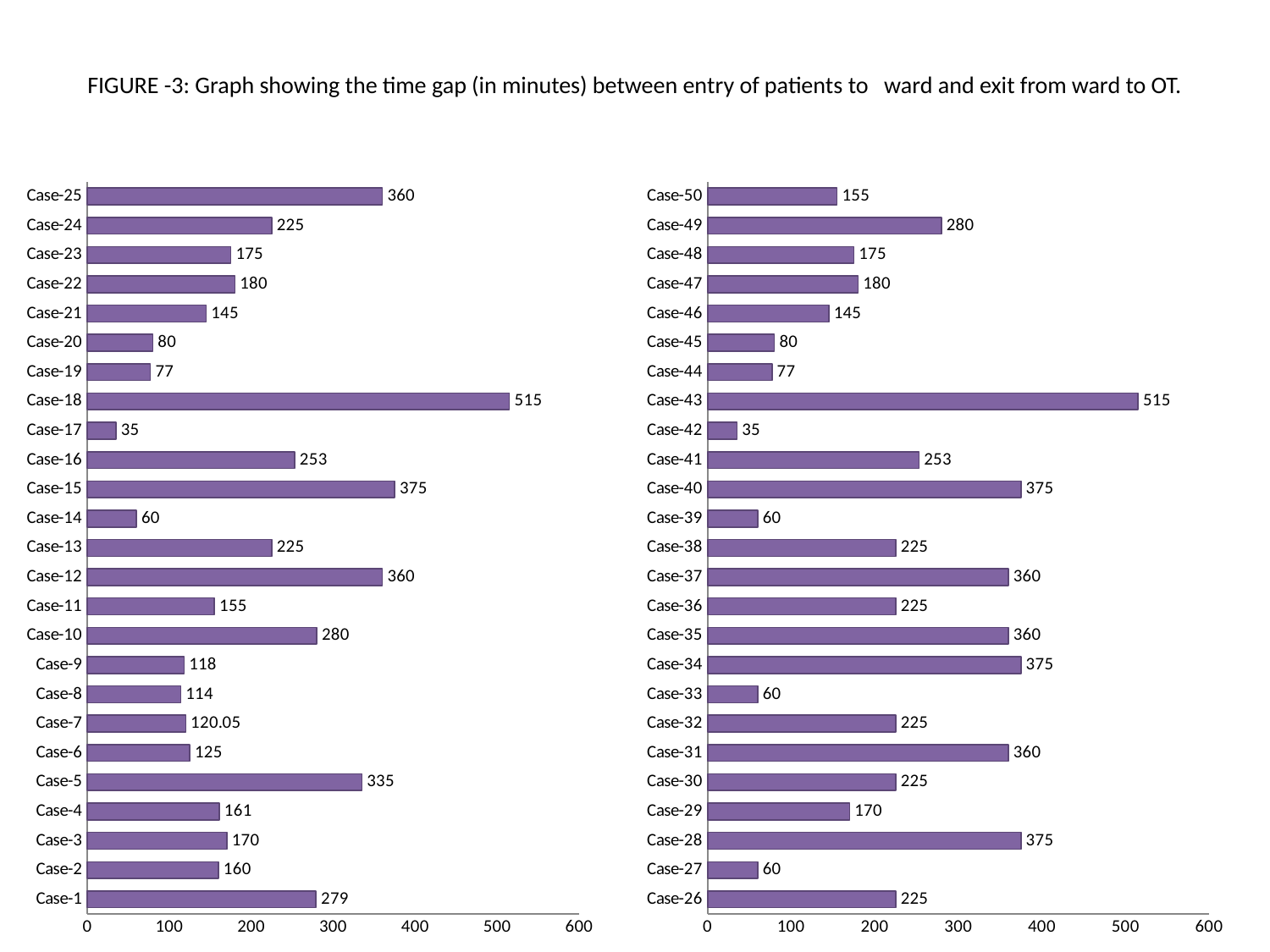
In the left chart (Case-1 to Case-25), which case has the highest value? Case-18 In the left chart (Case-1 to Case-25), what is the value for Case-7? 120.05 How many cases are plotted in the right chart (Case-26 to Case-50)? 25 What kind of chart is used on this slide? Bar chart In the left chart (Case-1 to Case-25), what is the difference between the values for Case-5 and Case-6? 210 In the right chart (Case-26 to Case-50), what is the value for Case-49? 280 In the right chart (Case-26 to Case-50), which is larger, the value for Case-28 or the value for Case-29? Case-28 In the right chart (Case-26 to Case-50), what is the difference between the values for Case-43 and Case-44? 438 In the left chart (Case-1 to Case-25), is the value for Case-1 greater or less than 200? greater What is the maximum value shown on the horizontal axis of the left chart? 600 In the left chart (Case-1 to Case-25), what is the value for Case-17? 35 In the right chart (Case-26 to Case-50), which case has the lowest value? Case-42